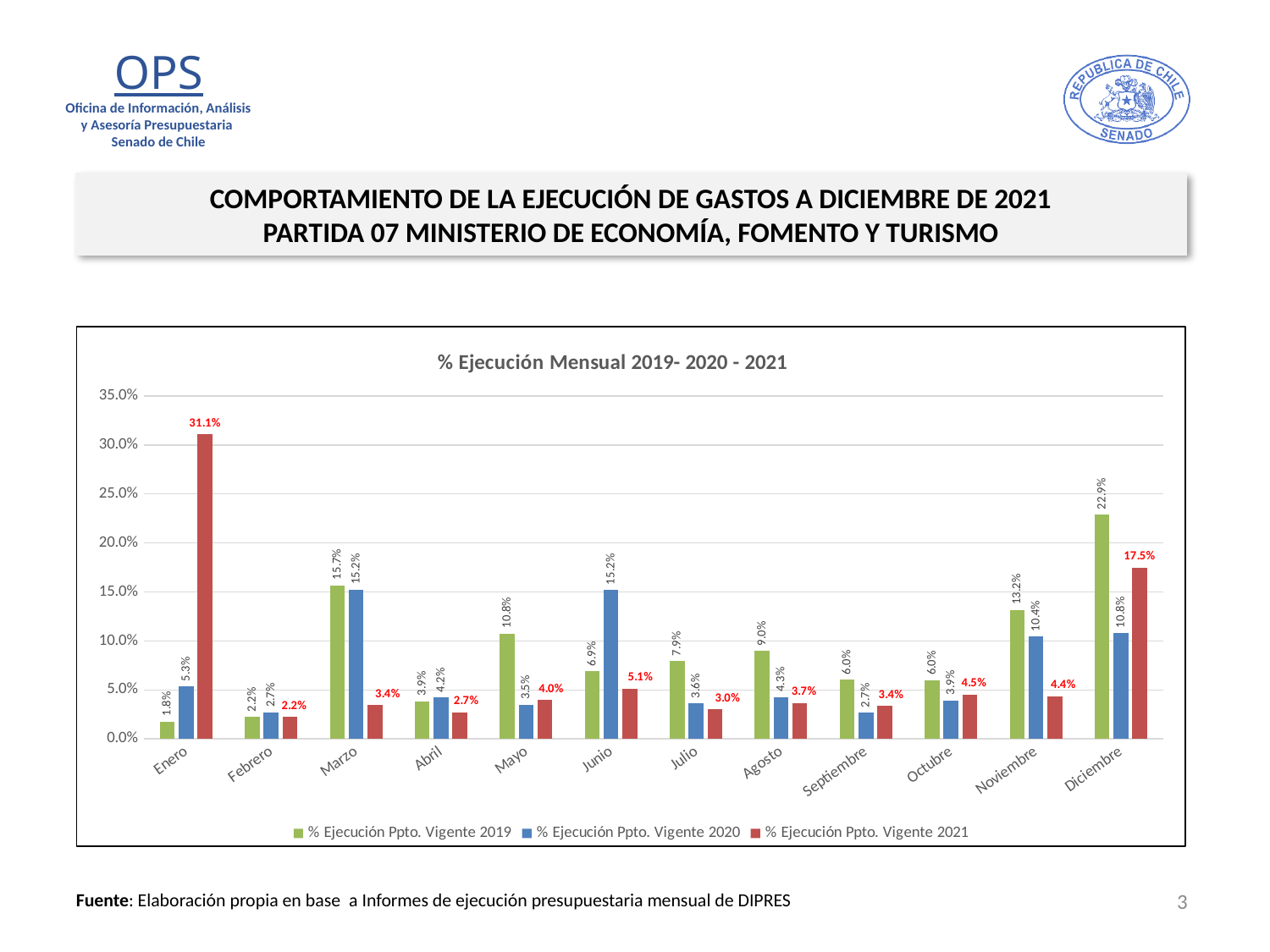
Which month has the highest value in the % Ejecución Ppto. Vigente 2021 series? Enero How many months are shown on the x axis? 12 What is the value for Diciembre in the % Ejecución Ppto. Vigente 2019 series? 22.9% What is the value for Enero in the % Ejecución Ppto. Vigente 2021 series? 31.1% Which month has the lowest value in the % Ejecución Ppto. Vigente 2019 series? Enero What kind of chart is shown on the slide? Bar chart What is the value for Junio in the % Ejecución Ppto. Vigente 2020 series? 15.2% Is the value for Noviembre in the 2019 series greater or less than 10.0%? greater What is the title of the chart? % Ejecución Mensual 2019- 2020 - 2021 What is the difference between the 2019 and 2021 values for Diciembre? 5.4% Which is larger for Marzo: the 2019 value or the 2021 value? 2019 value How many series does the legend list? 3